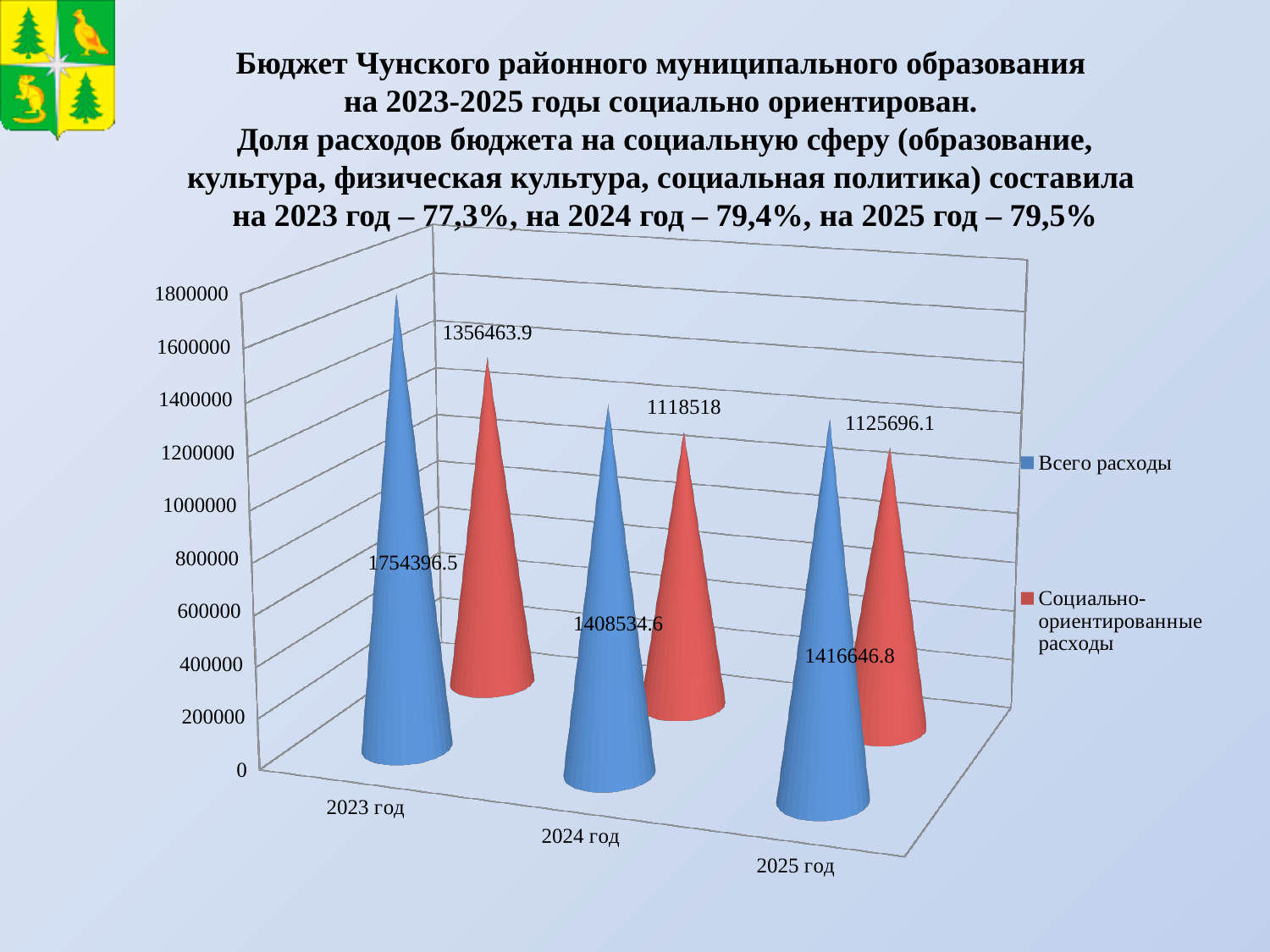
What is the difference between Всего расходы and Социально-ориентированные расходы in 2023 год? 397932.6 What is the value of Всего расходы for 2023 год? 1754396.5 What is the value of Социально-ориентированные расходы for 2023 год? 1356463.9 What kind of chart is shown on the slide? bar chart How many series does the legend list? 2 In which year is Всего расходы the highest? 2023 год How many years are shown on the x axis? 3 What is the value of Всего расходы for 2025 год? 1416646.8 Which is larger: Всего расходы in 2023 год or Всего расходы in 2024 год? 2023 год What is the value of Социально-ориентированные расходы for 2024 год? 1118518 In which year is Социально-ориентированные расходы the lowest? 2024 год Is the value of Всего расходы for 2023 год greater or less than 1600000? greater